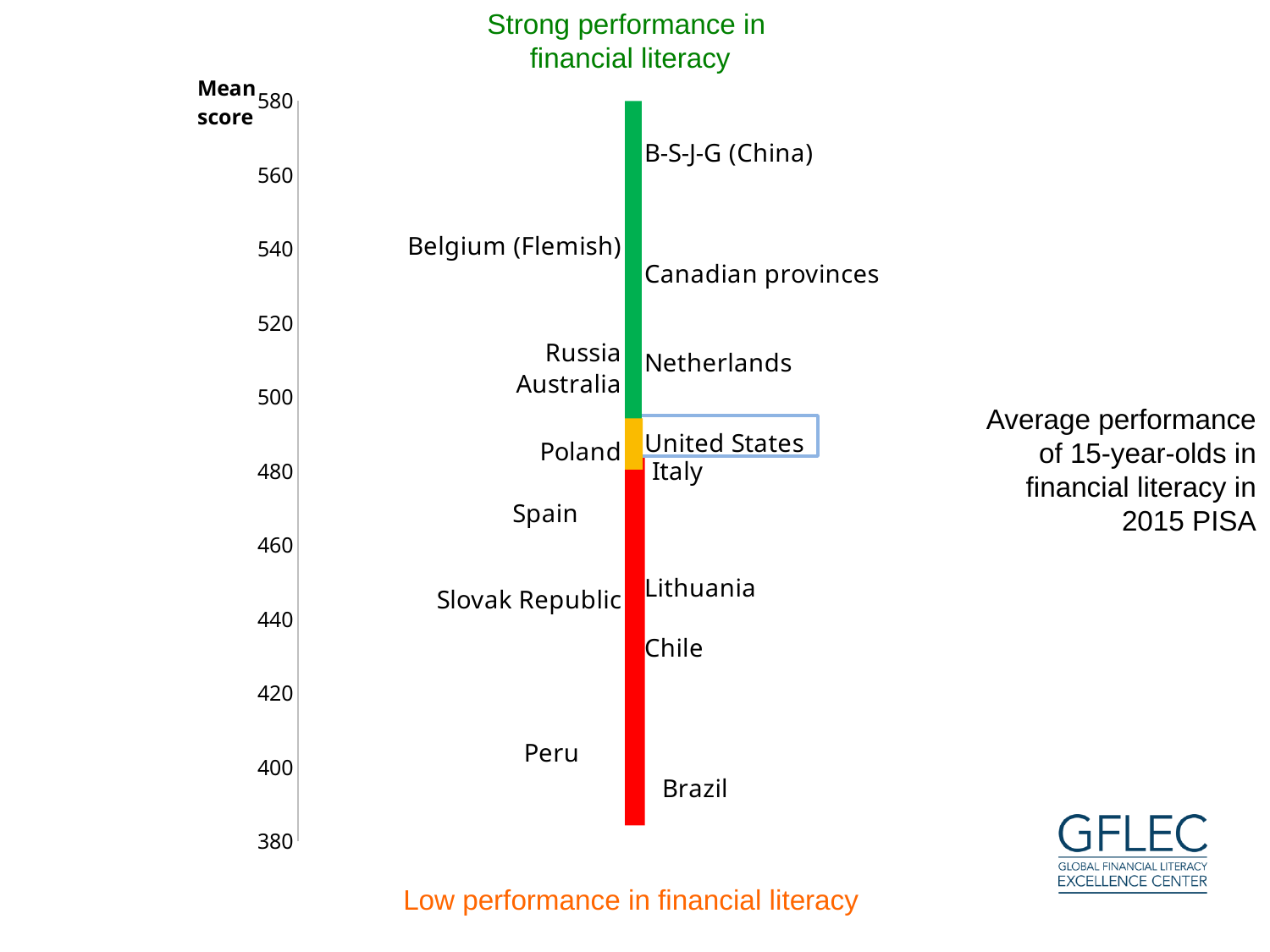
Is the mean score for B-S-J-G (China) greater or less than 540? greater Is the mean score for Peru greater or less than 420? less Is the mean score for Spain greater or less than 480? less How many countries or economies are labelled on the chart? 15 Which has the higher mean score, Poland or Spain? Poland What is the label on the vertical axis of the chart? Mean score Which country or economy has the highest mean score on the chart? B-S-J-G (China) Which has the higher mean score, the Netherlands or Italy? Netherlands Which country has the lowest mean score on the chart? Brazil